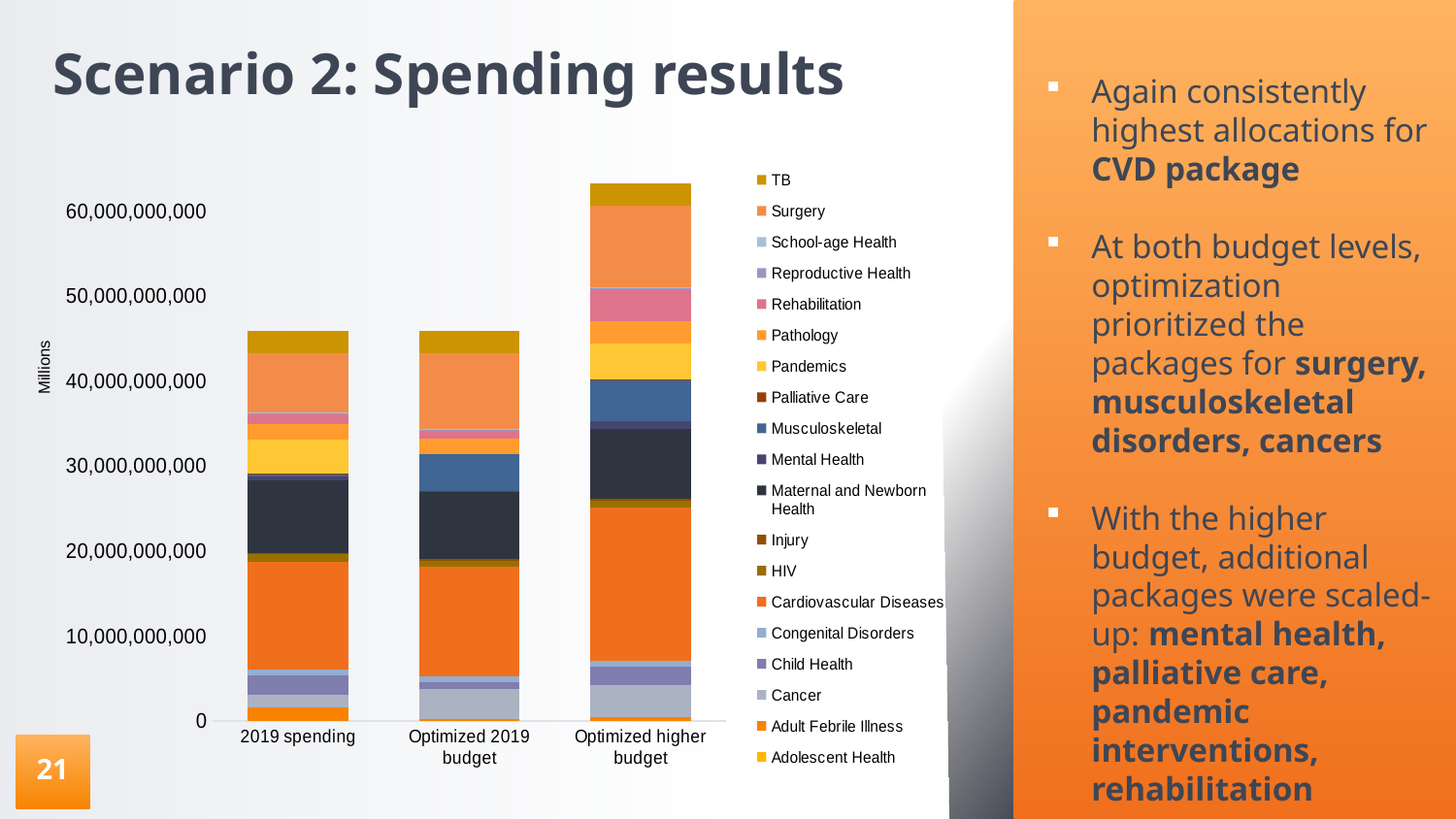
How many series does the chart's legend list? 19 What is the label on the vertical axis of the chart? Millions Which series has the largest segment in the Optimized higher budget bar? Cardiovascular Diseases What kind of chart is shown on the slide? Stacked bar chart Is the total for the Optimized higher budget bar greater or less than 60,000,000,000? greater How many categories (bars) are shown on the x axis of the chart? 3 Which bar has the highest total in the chart? Optimized higher budget In the 2019 spending bar, which segment is larger: Cardiovascular Diseases or Surgery? Cardiovascular Diseases Is the total for the 2019 spending bar greater or less than 40,000,000,000? greater Which series is listed first in the chart's legend? TB Is the total for the Optimized higher budget bar larger or smaller than the total for the 2019 spending bar? larger Is the total for the Optimized 2019 budget bar greater or less than 50,000,000,000? less